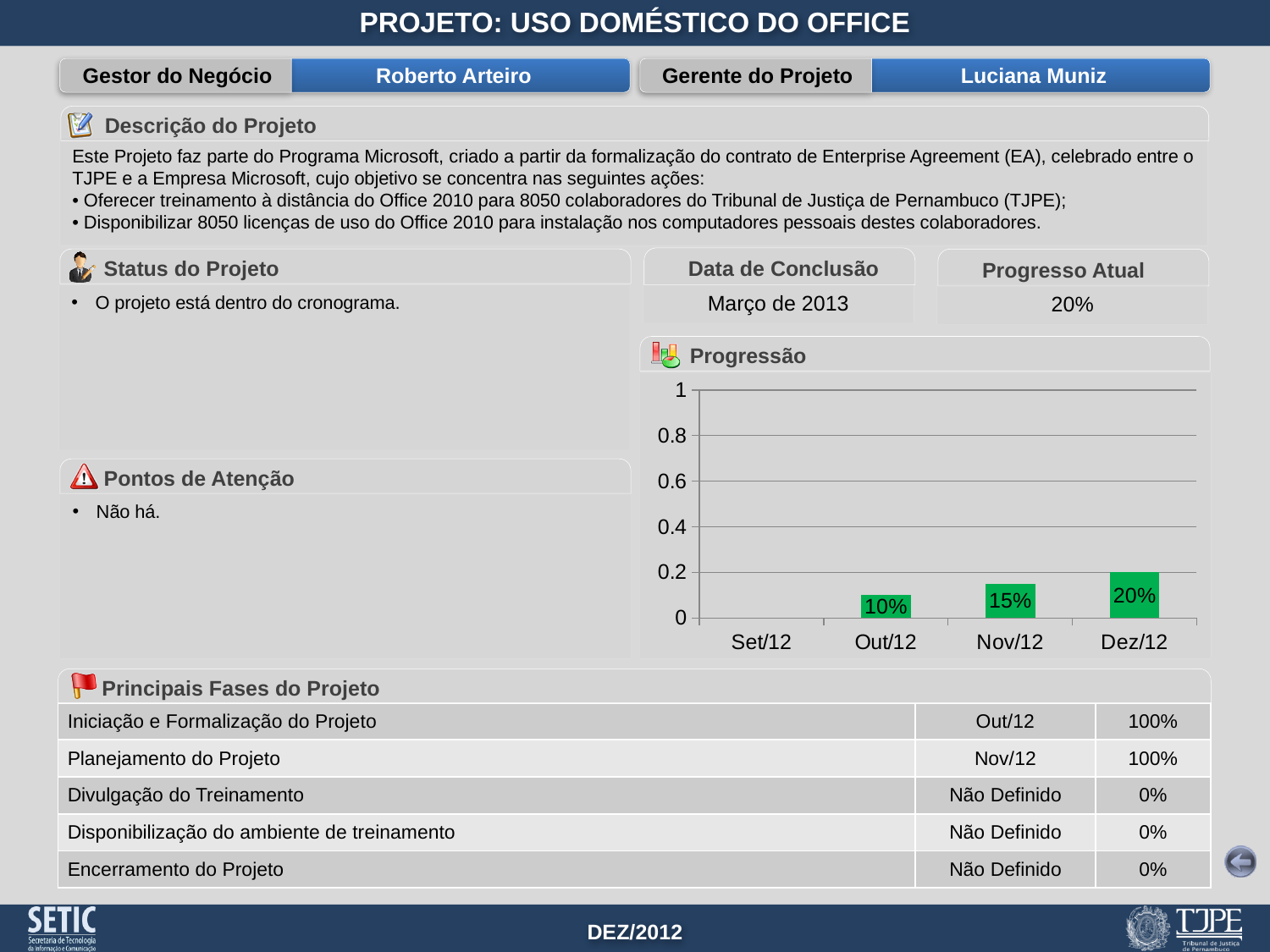
In the Progressão chart, which is larger: the value for Nov/12 or the value for Out/12? Nov/12 Which month has the highest value in the Progressão chart? Dez/12 What is the difference between the values for Dez/12 and Out/12 in the Progressão chart? 10% What colour are the bars in the Progressão chart? green Do the values in the Progressão chart rise or fall from Out/12 to Dez/12? rise What is the value shown for Nov/12 in the Progressão chart? 15% How many months are shown on the x axis of the Progressão chart? 4 In the Progressão chart, is the value for Dez/12 greater or less than 0.4? less What is the difference between the values for Nov/12 and Out/12 in the Progressão chart? 5% What kind of chart is the Progressão chart? bar chart What is the value shown for Dez/12 in the Progressão chart? 20% What is the value shown for Out/12 in the Progressão chart? 10%